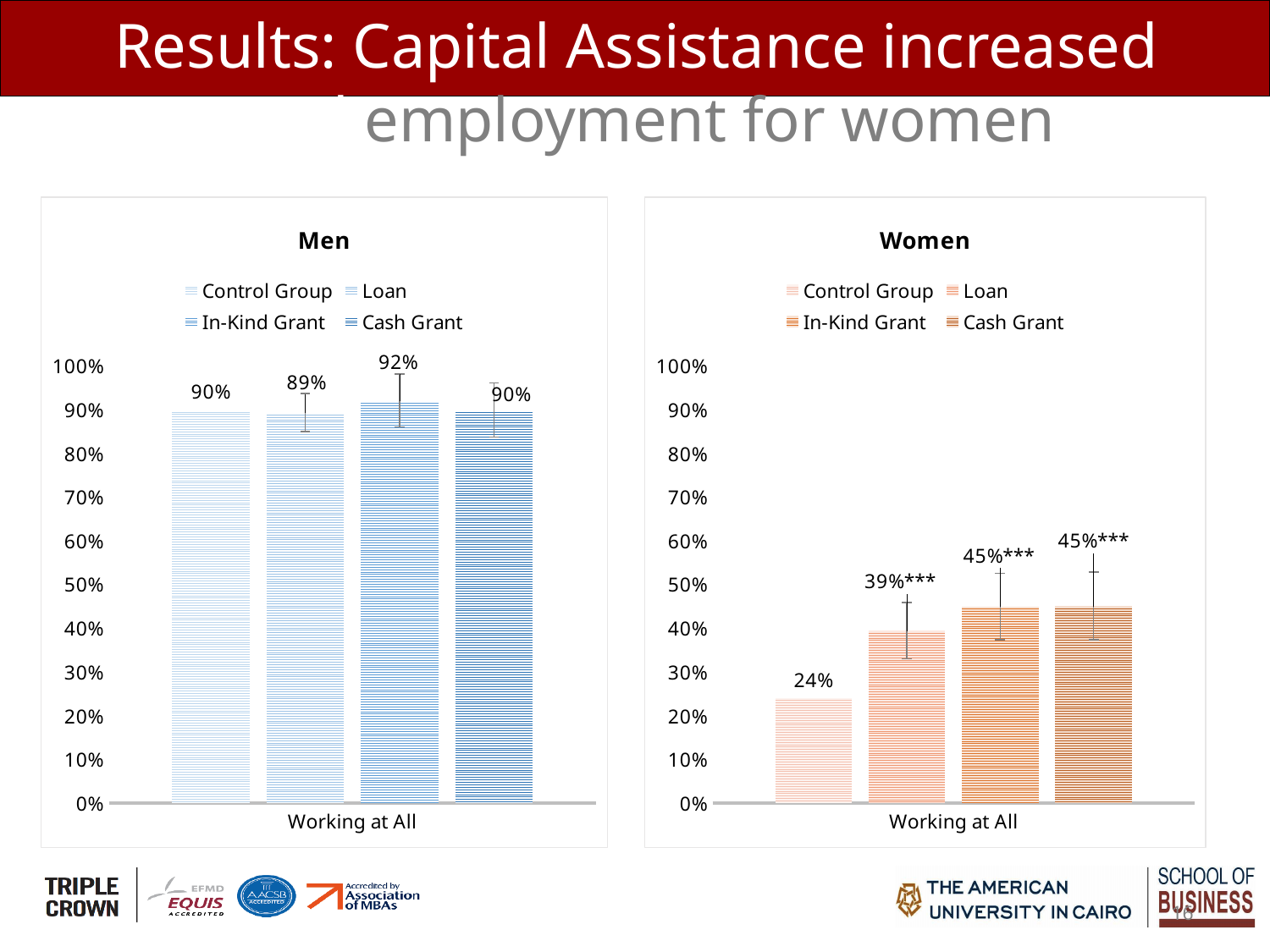
In the Women chart, what is the value for the Loan group? 39% In the Women chart, which group has the lowest value? Control Group What kind of chart is the Men chart? bar chart How many series does the legend of the Women chart list? 4 In the Women chart, what is the difference between the Cash Grant value and the Control Group value? 21% In the Men chart, what is the value for the In-Kind Grant group? 92% In the Women chart, is the value for the Control Group greater or less than 30%? less In the Women chart, what is the value for the Control Group? 24% In the Men chart, what is the value for the Loan group? 89% In the Women chart, which is larger, the Loan value or the In-Kind Grant value? In-Kind Grant What is the category label on the x axis of the Women chart? Working at All In the Men chart, which group has the highest value? In-Kind Grant